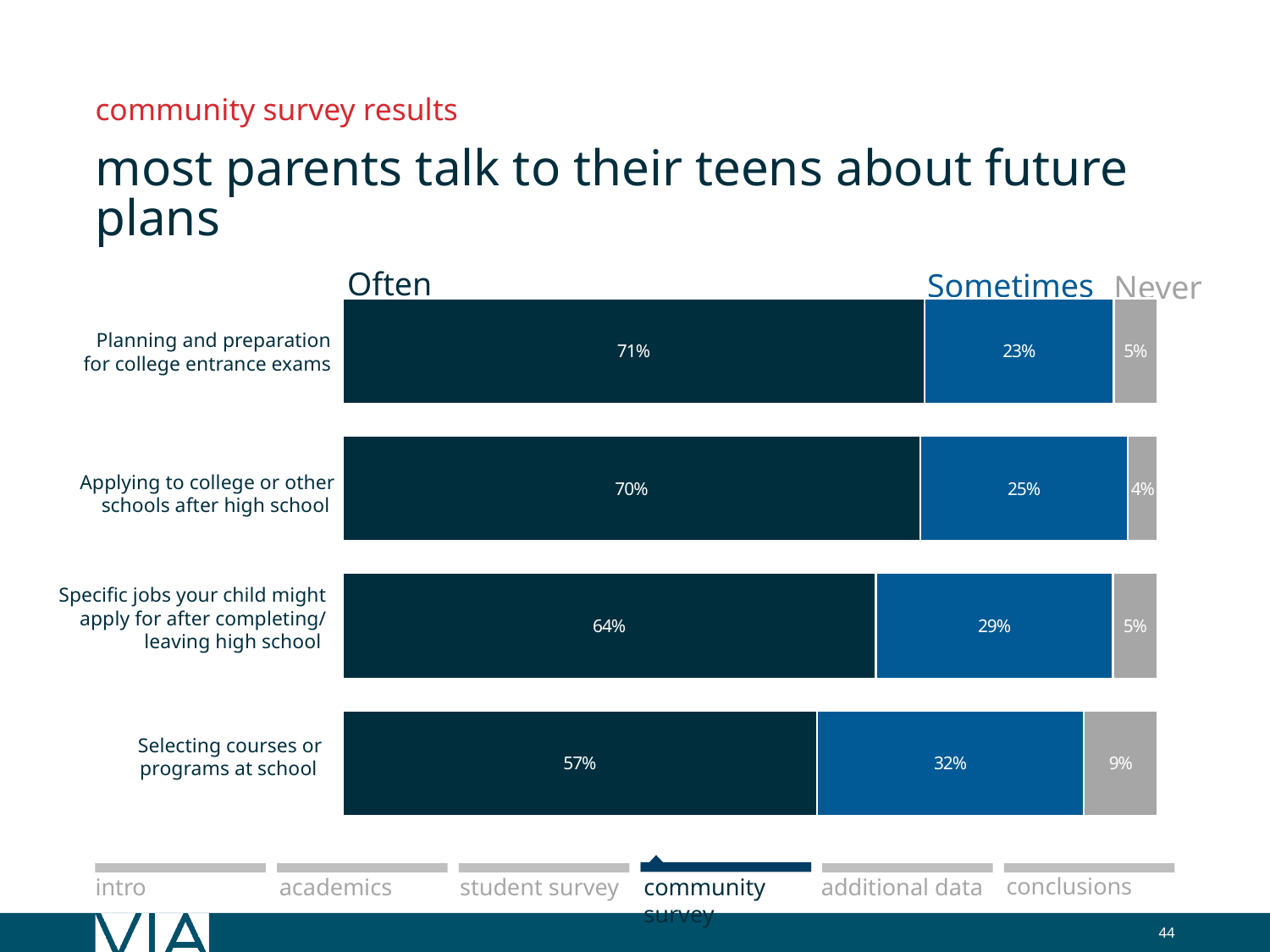
Which topic has the highest 'Never' percentage? Selecting courses or programs at school Which is larger: the 'Sometimes' percentage for specific jobs your child might apply for after completing/leaving high school, or the 'Sometimes' percentage for applying to college or other schools after high school? Specific jobs your child might apply for after completing/leaving high school What type of chart is shown on the slide? Stacked bar chart What are the three response categories labelled above the bars? Often, Sometimes, Never What is the difference between the 'Often' percentages for planning and preparation for college entrance exams and selecting courses or programs at school? 14% What percentage of parents 'Sometimes' talk to their teens about selecting courses or programs at school? 32% What percentage of parents say they 'Often' talk to their teens about planning and preparation for college entrance exams? 71% Which topic has the lowest 'Often' percentage? Selecting courses or programs at school Which topic has the highest 'Often' percentage? Planning and preparation for college entrance exams How many response categories (series) does the chart show? 3 How many topics (categories) are shown in the chart? 4 What percentage of parents 'Never' talk to their teens about applying to college or other schools after high school? 4%